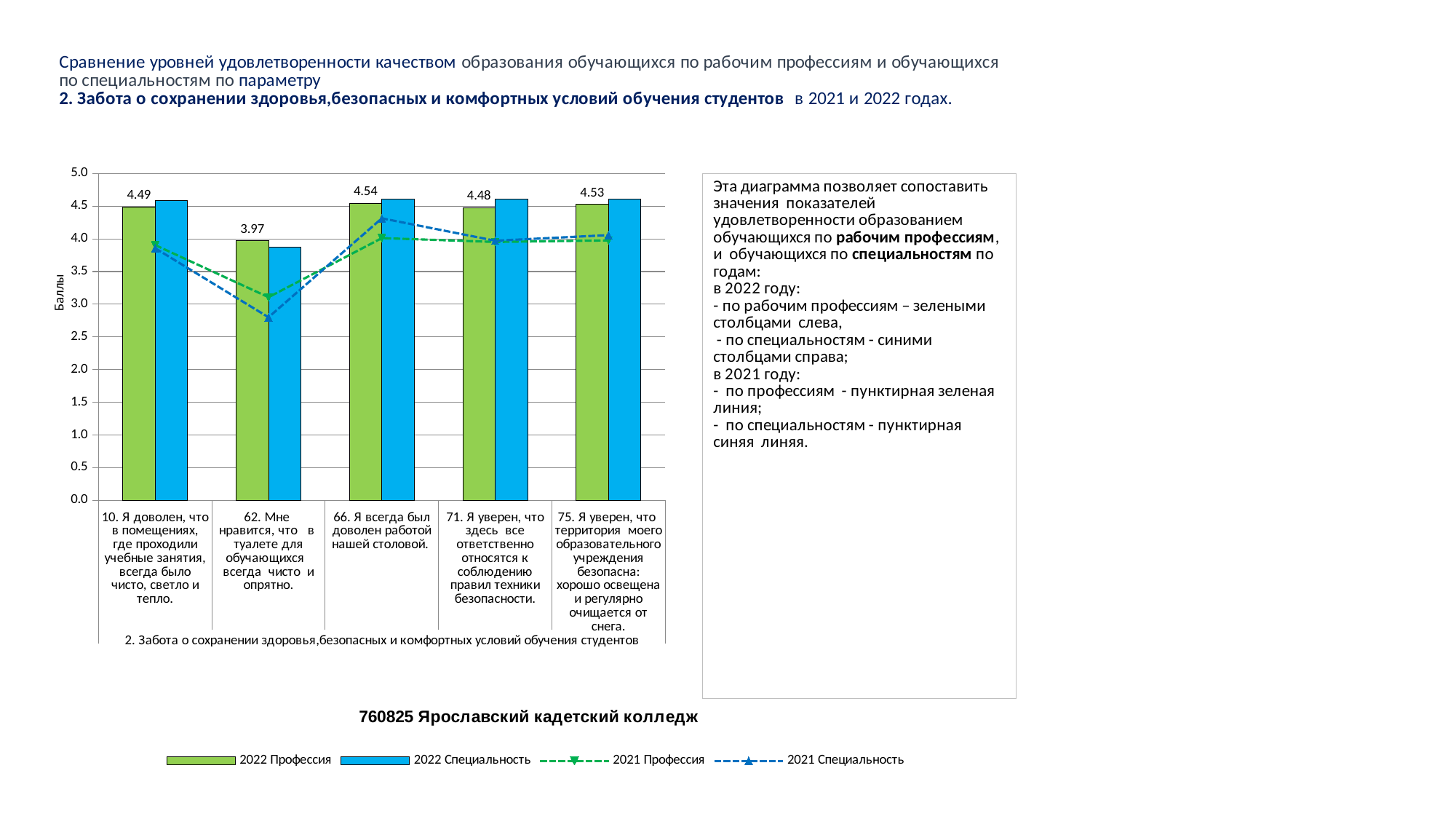
Is the 2021 Специальность value for category 62 (туалет) greater or less than 3.0? less What is the value of the 2022 Профессия bar for category "10. Я доволен, что в помещениях, где проходили учебные занятия, всегда было чисто, светло и тепло."? 4.49 What is the value of the 2022 Профессия bar for category "66. Я всегда был доволен работой нашей столовой."? 4.54 Which is larger: the 2022 Профессия value for category 10 (помещения) or for category 62 (туалет)? Category 10 (4.49) Is the 2022 Специальность value for category 62 (туалет) greater or less than 4.0? less How many series does the chart legend list? 4 What is the difference between the 2022 Профессия values for category 66 (столовая) and category 62 (туалет)? 0.57 Which category has the lowest 2022 Профессия value? 62. Мне нравится, что в туалете для обучающихся всегда чисто и опрятно. What is the label of the vertical axis of the chart? Баллы What is the value of the 2022 Профессия bar for category "62. Мне нравится, что в туалете для обучающихся всегда чисто и опрятно."? 3.97 Which category has the highest 2022 Профессия value? 66. Я всегда был доволен работой нашей столовой. How many categories are shown on the x axis of the chart? 5